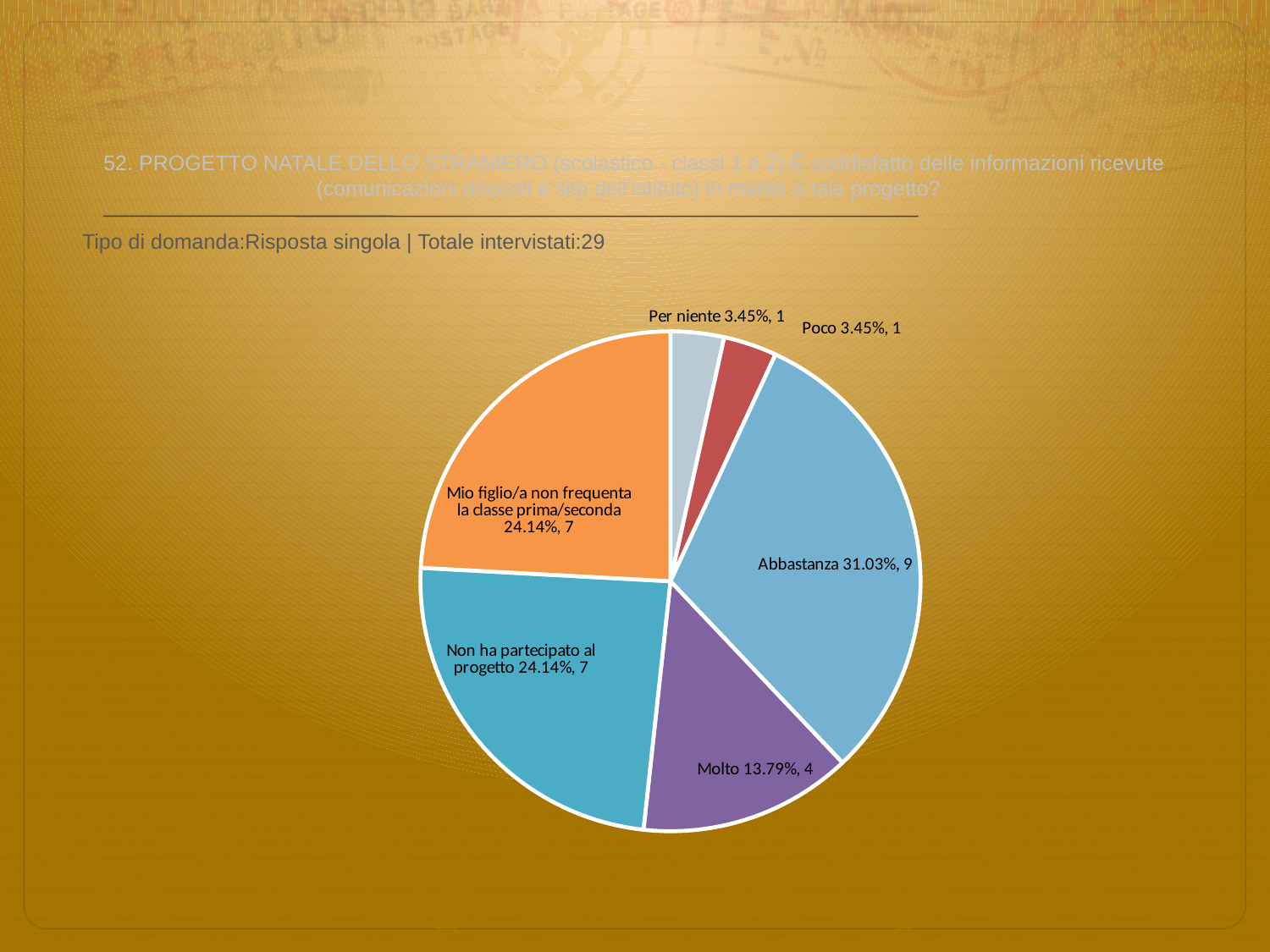
What percentage share does the "Abbastanza" slice have? 31.03% How many respondents answered "Per niente"? 1 What is the combined number of respondents for "Per niente" and "Poco"? 2 Which category has the largest slice of the pie? Abbastanza Which has more respondents, "Molto" or "Non ha partecipato al progetto"? Non ha partecipato al progetto What kind of chart is shown on the slide? pie chart What is the difference in respondent count between "Abbastanza" and "Molto"? 5 How many respondents answered "Molto"? 4 What is the total number of interviewees stated on the slide? 29 What percentage is shown for "Non ha partecipato al progetto"? 24.14% How many slices does the pie chart have? 6 What percentage is shown for "Mio figlio/a non frequenta la classe prima/seconda"? 24.14%